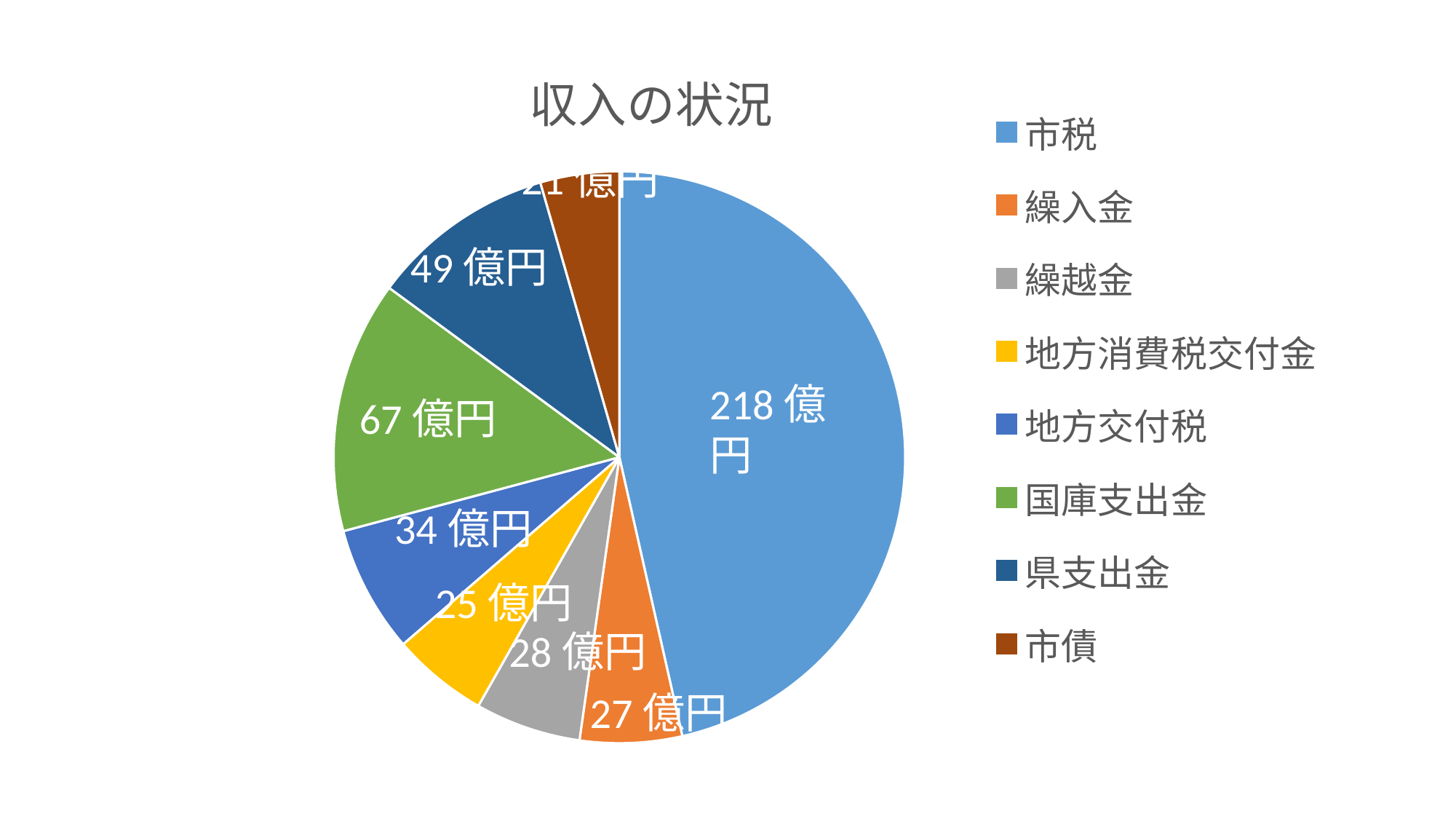
What is the title of the chart? 収入の状況 What is the value for 地方消費税交付金? 25 億円 What is the value for 県支出金? 49 億円 Which category has the largest slice of the pie? 市税 What is the difference between 国庫支出金 and 県支出金? 18 億円 What is the value for 地方交付税? 34 億円 What is the value for 国庫支出金? 67 億円 Which category has the smallest slice of the pie? 市債 How many categories are shown in the pie chart? 8 What is the value for 市税 in the pie chart? 218 億円 Which is larger, 繰越金 or 繰入金? 繰越金 What kind of chart is shown on the slide? Pie chart